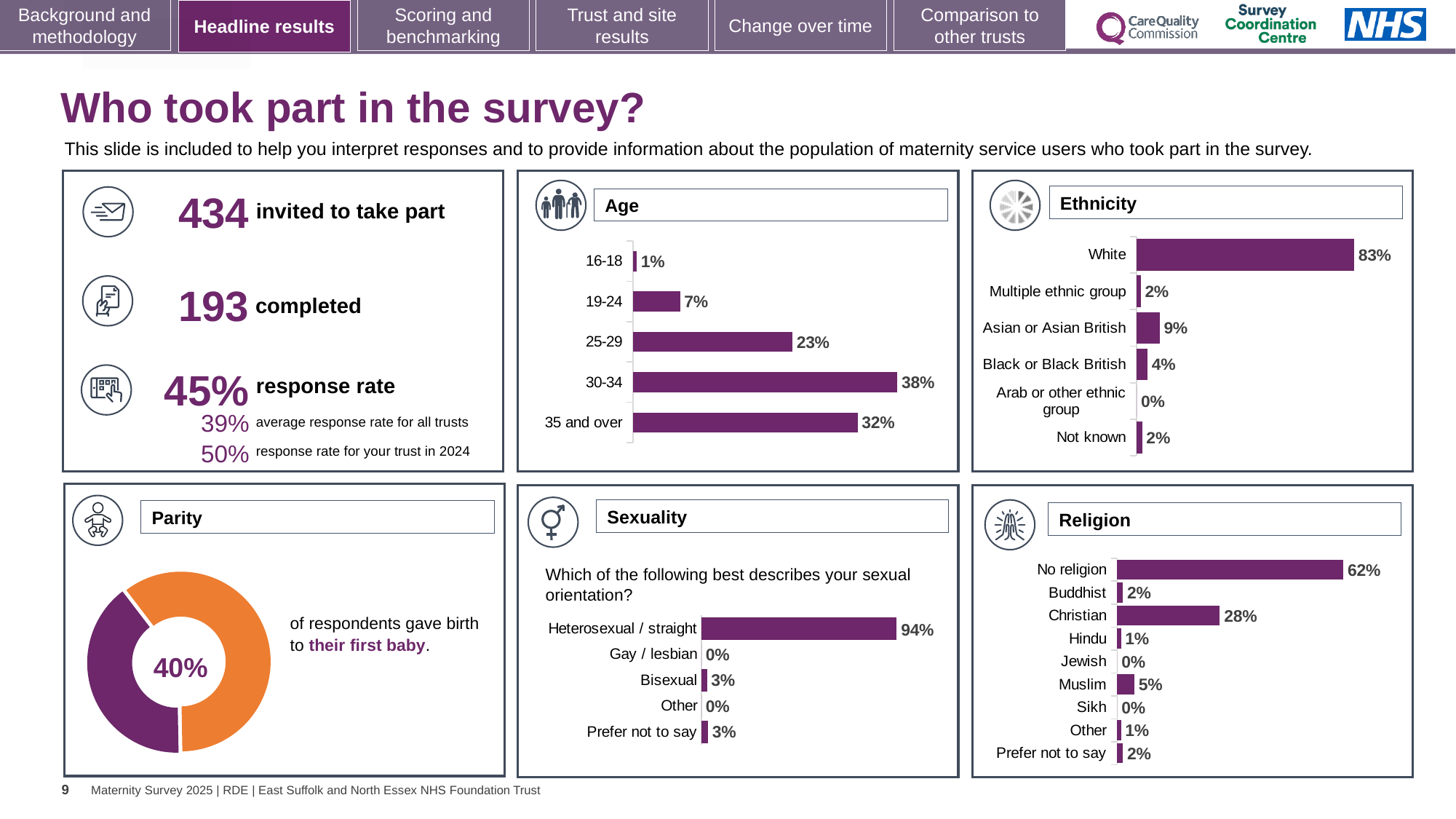
In the Age chart, what is the difference between the 30-34 and 35 and over percentages? 6% What kind of chart is the Parity chart? Doughnut chart In the Parity chart, what percentage of respondents gave birth to their first baby? 40% In the Religion chart, what is the difference between No religion and Christian? 34% In the Ethnicity chart, what percentage of respondents were White? 83% In the Age chart, what percentage of respondents were aged 30-34? 38% How many categories are shown in the Religion chart? 9 In the Ethnicity chart, which is larger: Asian or Asian British or Black or Black British? Asian or Asian British How many categories are shown in the Ethnicity chart? 6 In the Sexuality chart, what percentage of respondents answered Bisexual? 3% In the Religion chart, which category has the highest percentage? No religion In the Age chart, which age group has the lowest percentage? 16-18